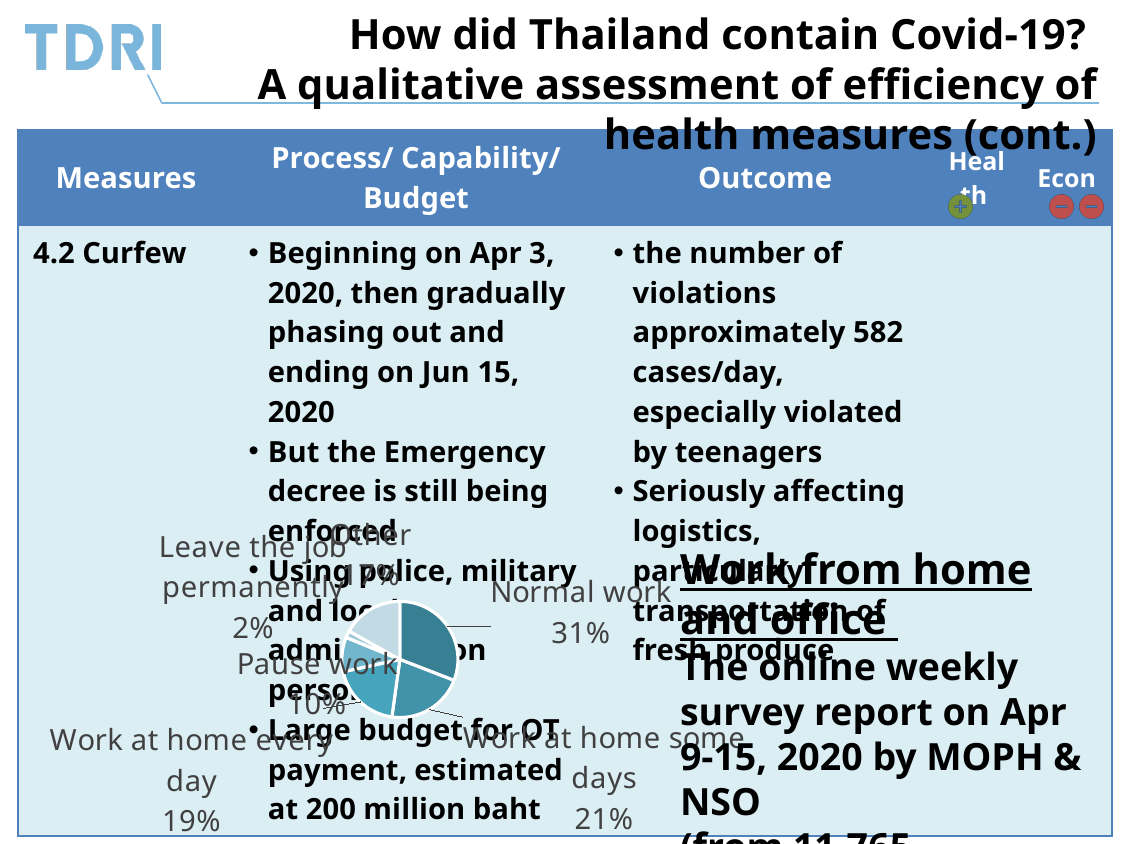
What kind of chart is shown on the slide? pie chart Which category has the smallest slice in the pie chart? Leave the job permanently What share of the pie chart is labelled "Work at home some days"? 21% What is the difference in percentage points between "Normal work" and "Work at home every day" in the pie chart? 12 What share of the pie chart is labelled "Pause work"? 10% Which is larger in the pie chart, "Work at home some days" or "Other"? Work at home some days What share of the pie chart is labelled "Normal work"? 31% Which category has the largest slice in the pie chart? Normal work What share of the pie chart is labelled "Work at home every day"? 19% How many categories are shown in the pie chart? 6 What share of the pie chart is labelled "Other"? 17% What share of the pie chart is labelled "Leave the job permanently"? 2%